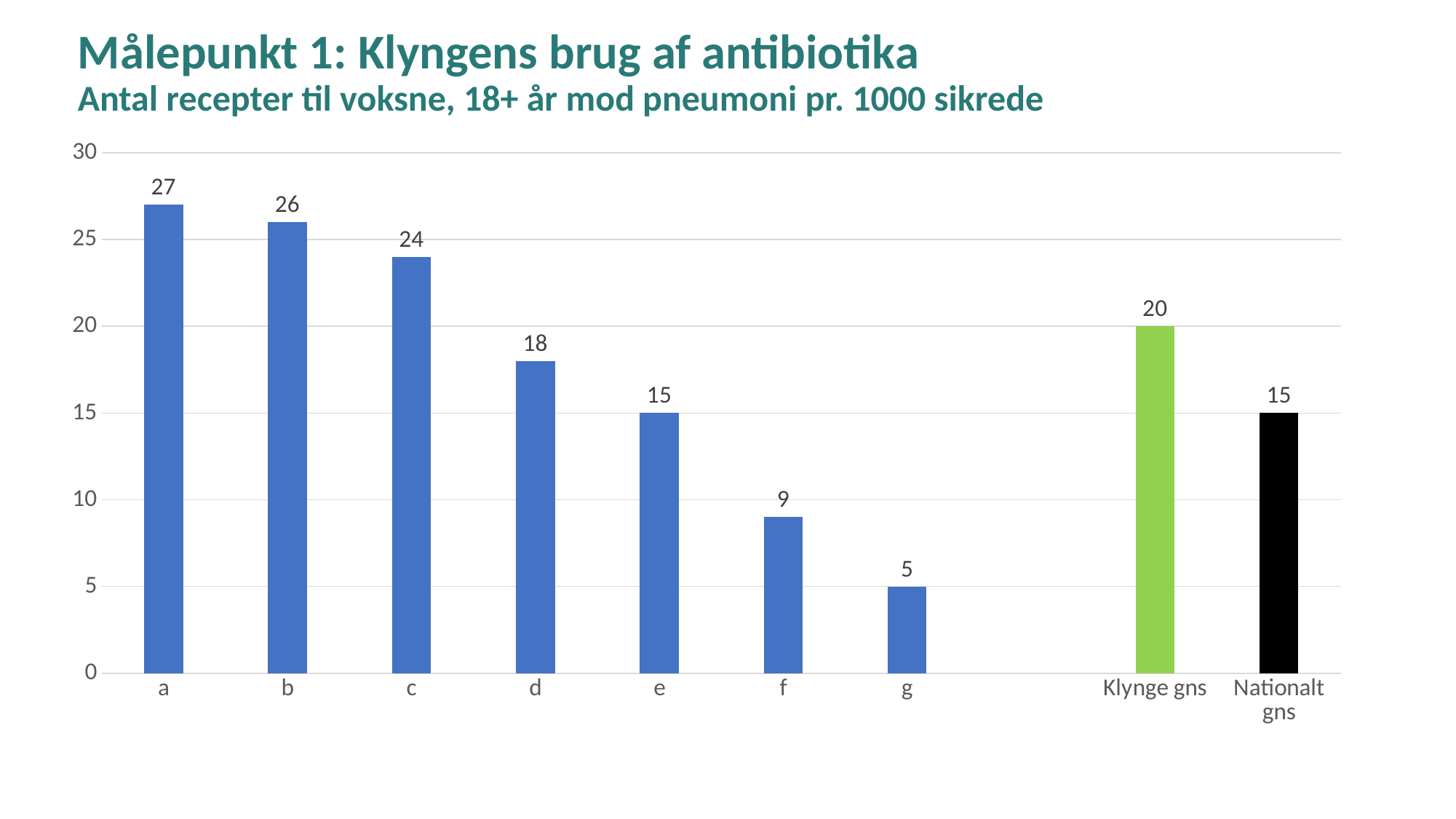
Which category has the highest value? a Which category has the lowest value? g Is the value for c greater or less than 20? greater How many bars are plotted in the chart? 9 Which is larger, the value for d or the value for e? d What is the difference between the values for a and g? 22 What is the value for Nationalt gns? 15 Do the values rise or fall from category a to category g? fall What is the value for Klynge gns? 20 What is the difference between Klynge gns and Nationalt gns? 5 What kind of chart is shown on the slide? bar chart What is the value for category a? 27